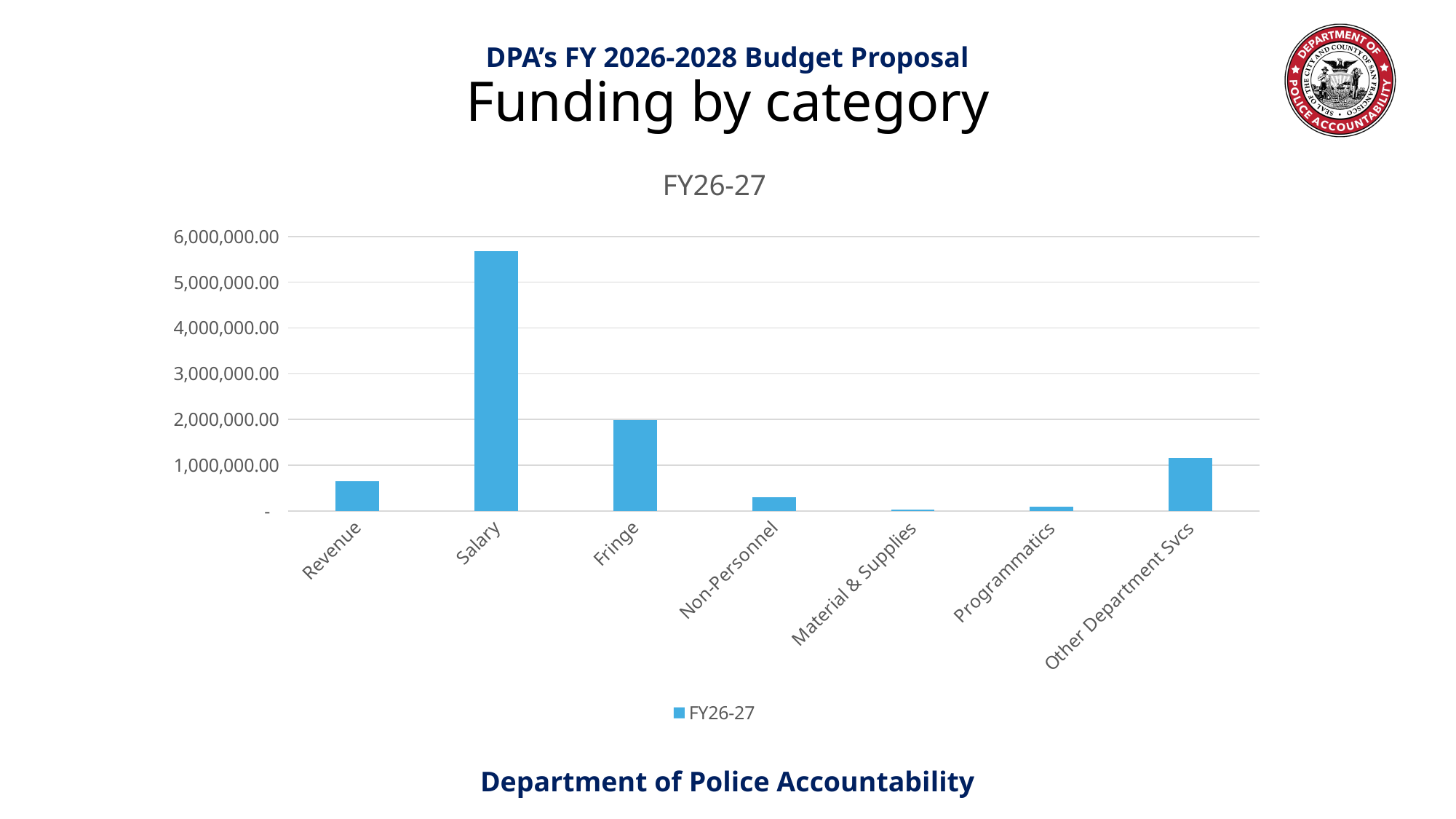
Is the value for Non-Personnel greater or less than 1,000,000.00? less Which category has the highest value in the chart? Salary Which is larger, the value for Fringe or the value for Other Department Svcs? Fringe What is the title of the chart? FY26-27 Is the value for Salary greater or less than 5,000,000.00? greater How many series does the chart's legend list? 1 What type of chart is shown on the slide? Bar chart Which category has the lowest value in the chart? Material & Supplies How many categories are shown on the x axis of the chart? 7 Is the value for Fringe greater or less than 1,000,000.00? greater Which is larger, the value for Revenue or the value for Non-Personnel? Revenue